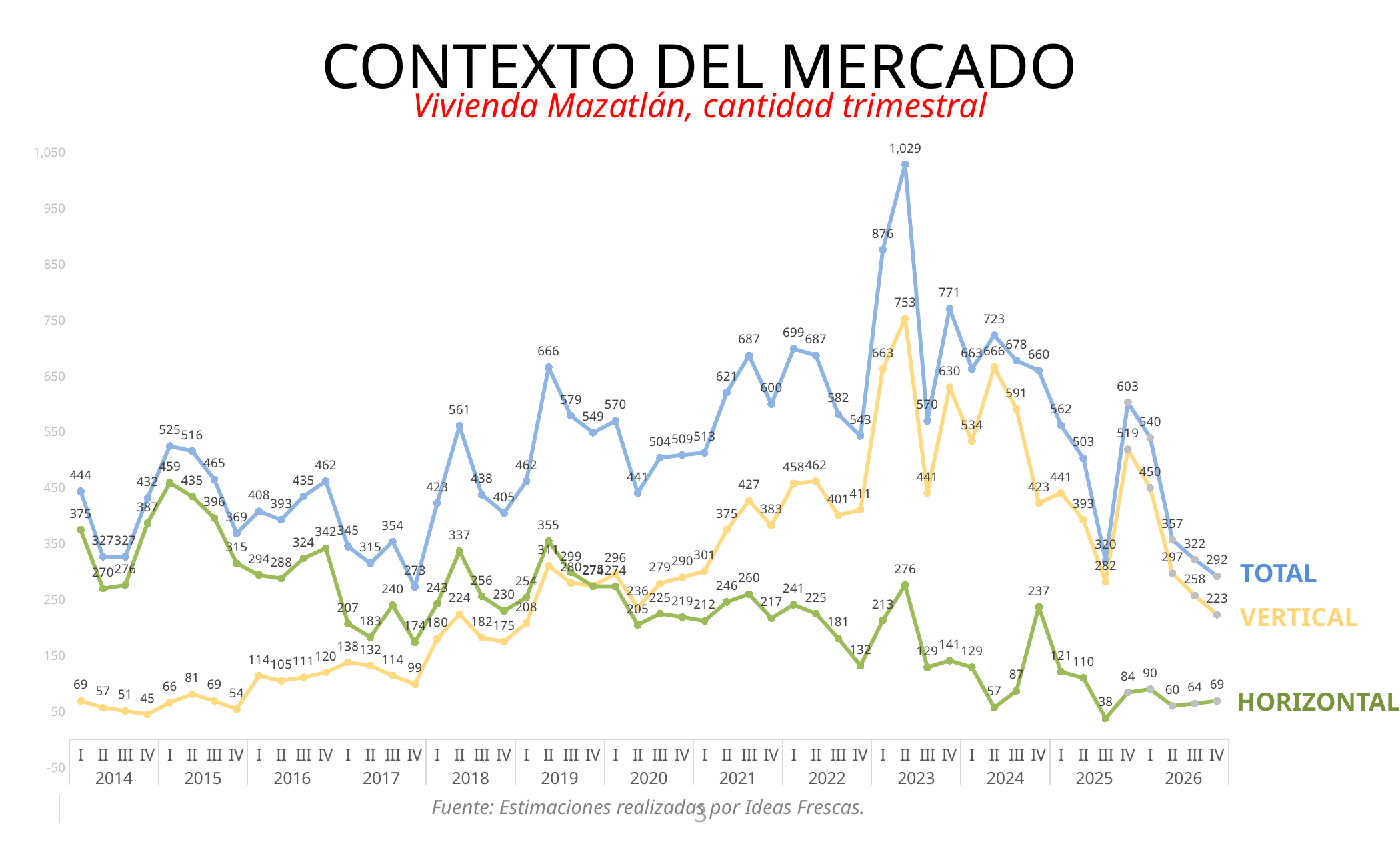
Does the TOTAL series rise or fall across the four quarters of 2026? fall How many years are shown on the x axis? 13 In which quarter does the TOTAL series reach its highest value? II 2023 How many series does the chart show? 3 What is the TOTAL value for quarter II of 2023? 1,029 What type of chart is shown on the slide? line chart In quarter II of 2024, which is larger: the VERTICAL value or the HORIZONTAL value? VERTICAL What is the difference between the TOTAL values for quarter II of 2023 and quarter I of 2023? 153 What is the subtitle shown in red below the chart title? Vivienda Mazatlán, cantidad trimestral In which quarter does the VERTICAL series reach its lowest value? IV 2014 What is the HORIZONTAL value for quarter III of 2025? 38 What is the VERTICAL value for quarter II of 2023? 753